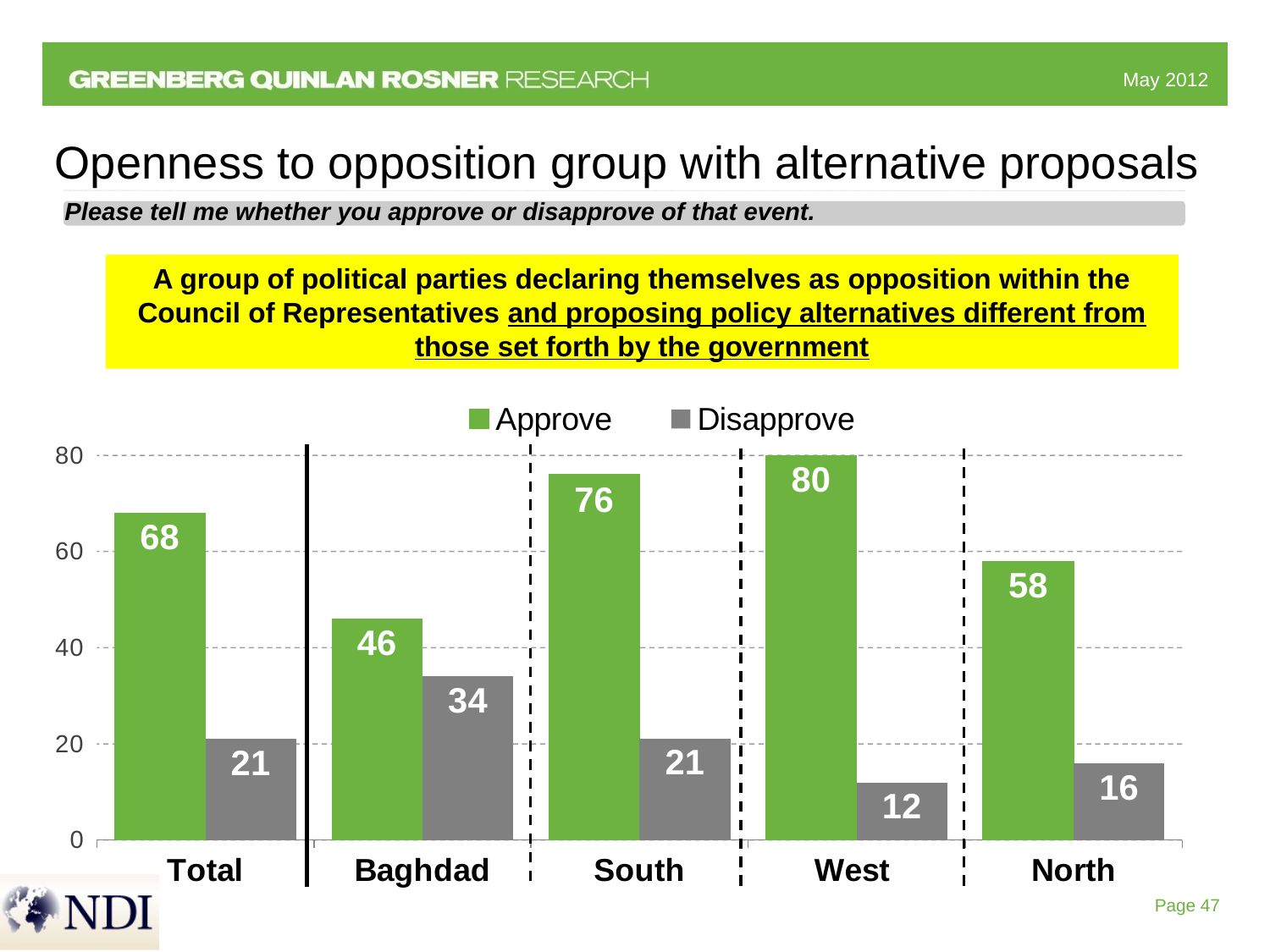
Which is larger, the Approve value for North or the Approve value for Total? Total What kind of chart is shown on the slide? Bar chart Which category has the highest Approve value? West Which category has the highest Disapprove value? Baghdad What is the Approve value for Total? 68 How many series does the legend list? 2 What is the Disapprove value for West? 12 What colour are the Approve bars? Green What is the difference between the Approve and Disapprove values for South? 55 How many categories are shown on the x axis? 5 What is the Approve value for Baghdad? 46 Which category has the lowest Approve value? Baghdad